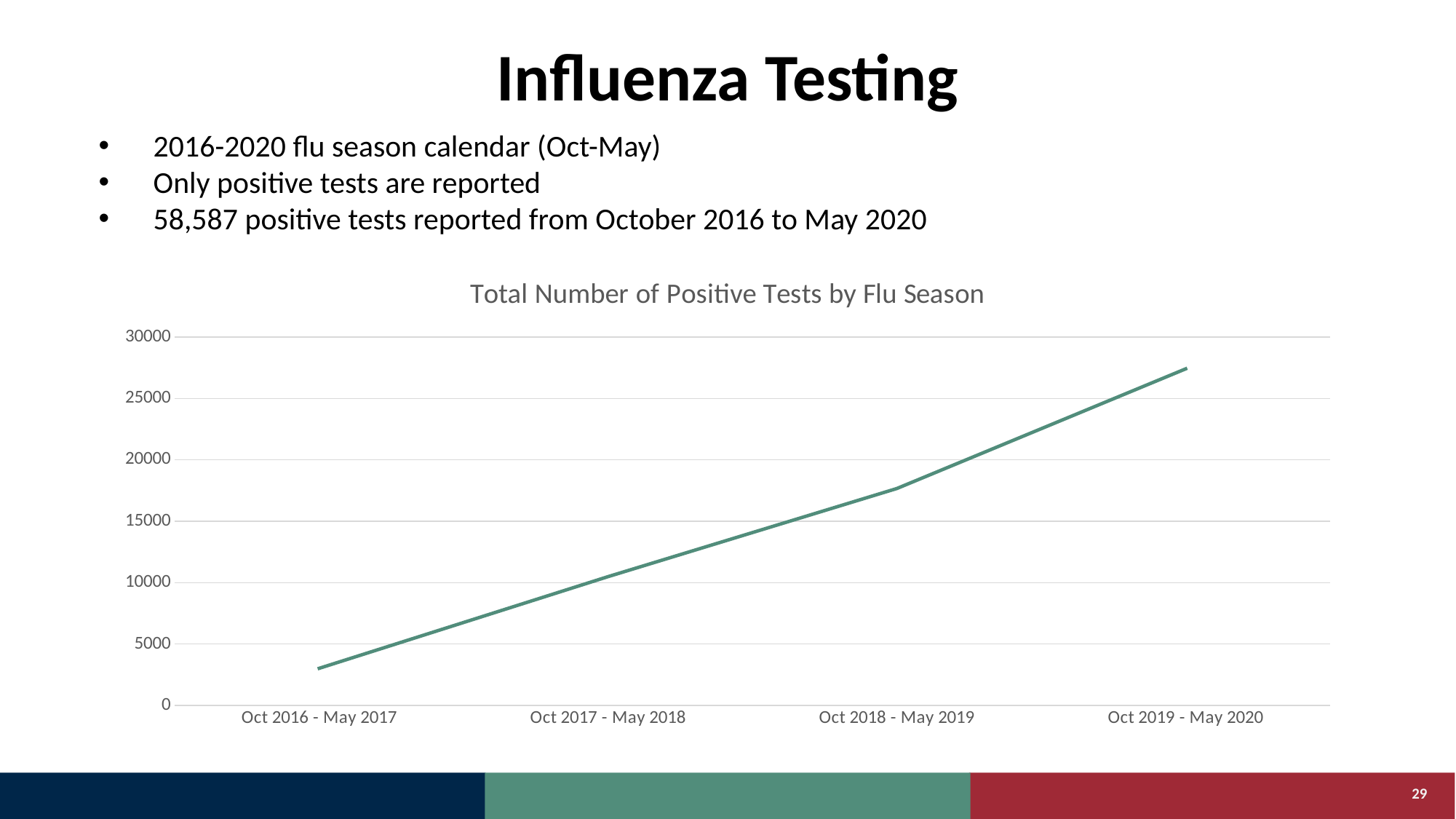
What is the title of the chart? Total Number of Positive Tests by Flu Season Which flu season has the highest number of positive tests? Oct 2019 - May 2020 What is the highest value shown on the y axis of the chart? 30000 What kind of chart is shown on the slide? line chart Is the value for Oct 2019 - May 2020 greater or less than 25000? greater Do the values rise or fall from Oct 2016 - May 2017 to Oct 2019 - May 2020? rise Which flu season has the lowest number of positive tests? Oct 2016 - May 2017 Is the value for Oct 2018 - May 2019 greater or less than 20000? less Is the value for Oct 2016 - May 2017 greater or less than 5000? less Which is larger, the value for Oct 2017 - May 2018 or the value for Oct 2018 - May 2019? Oct 2018 - May 2019 How many flu seasons are plotted on the x axis of the chart? 4